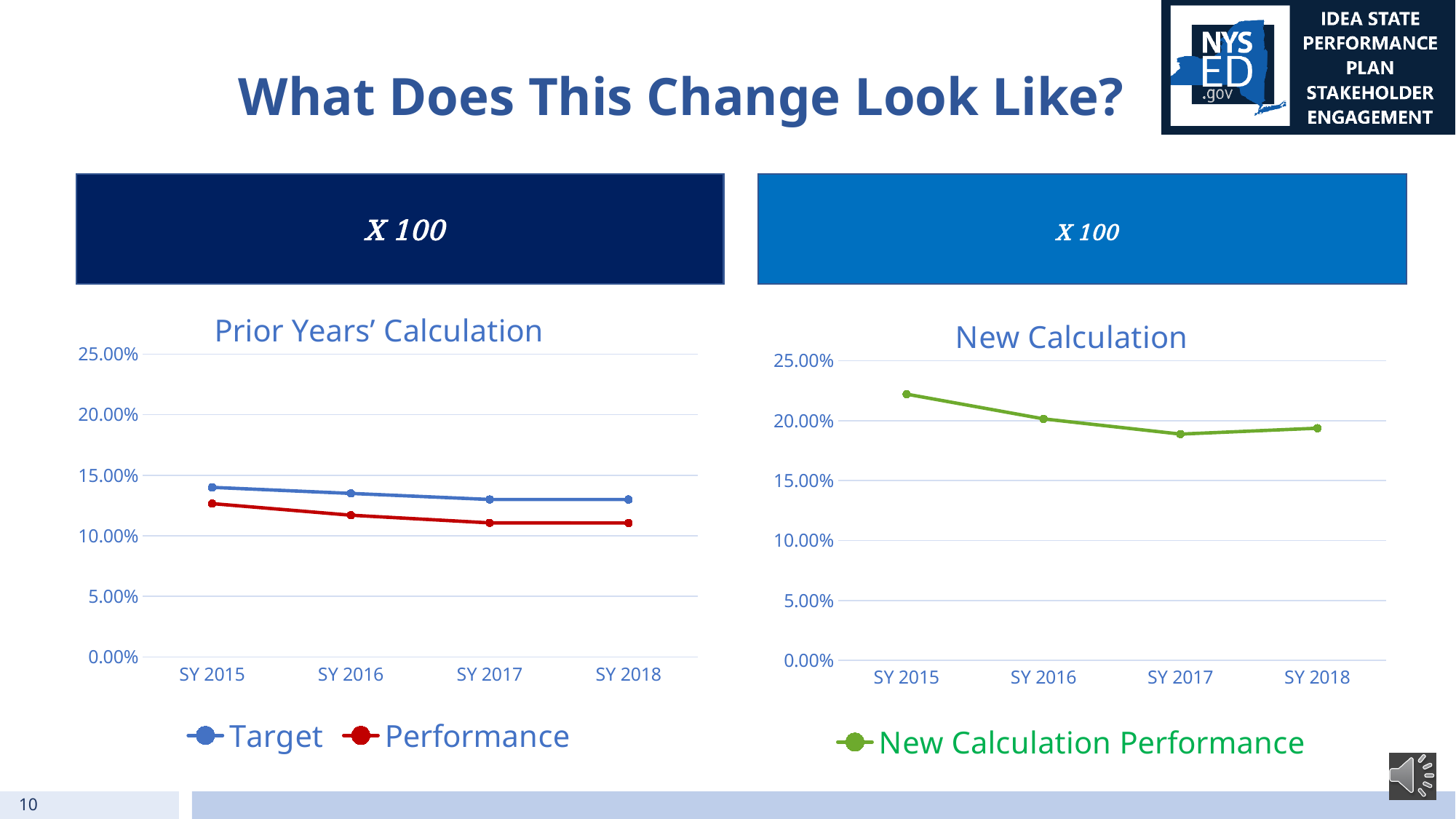
In the 'New Calculation' chart, is the value for SY 2017 greater or less than 20.00%? less In the 'New Calculation' chart, is the value for SY 2015 greater or less than 20.00%? greater How many series does the legend of the 'Prior Years' Calculation' chart list? 2 What kind of chart is the 'Prior Years' Calculation' chart? line chart In the 'Prior Years' Calculation' chart, is the Performance value for SY 2017 greater or less than 10.00%? greater What is the name of the series in the legend of the 'New Calculation' chart? New Calculation Performance In the 'Prior Years' Calculation' chart, does the Performance line rise or fall from SY 2015 to SY 2017? fall In the 'New Calculation' chart, which school year has the lowest value? SY 2017 In the 'New Calculation' chart, which school year has the highest value? SY 2015 How many school years are shown on the x axis of the 'New Calculation' chart? 4 In the 'Prior Years' Calculation' chart, which series is higher in SY 2016, Target or Performance? Target